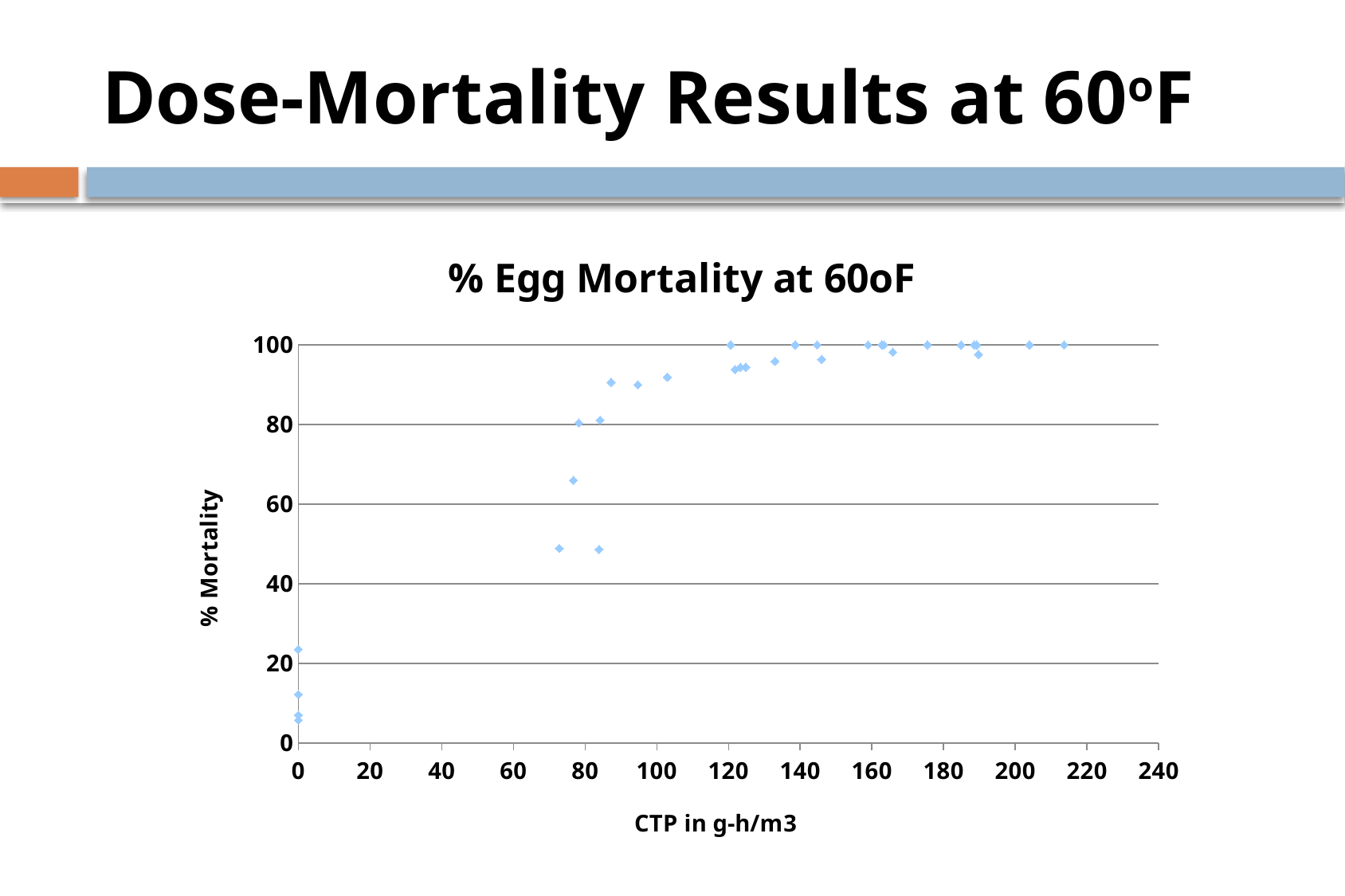
What is the label of the x axis of the chart? CTP in g-h/m3 What is the highest value shown on the x axis of the chart? 240 Are the % Mortality values at a CTP of 0 greater or less than 40? less Are the % Mortality values at CTP above 120 greater or less than 80? greater Are the % Mortality values at CTP of about 87 greater or less than 80? greater Which has the higher % Mortality: the points at a CTP of 0 or the points at a CTP of about 200? the points at a CTP of about 200 Do the % Mortality values generally rise or fall as CTP increases along the x axis? rise What is the title of the chart? % Egg Mortality at 60oF What kind of chart is shown on the slide? scatter chart